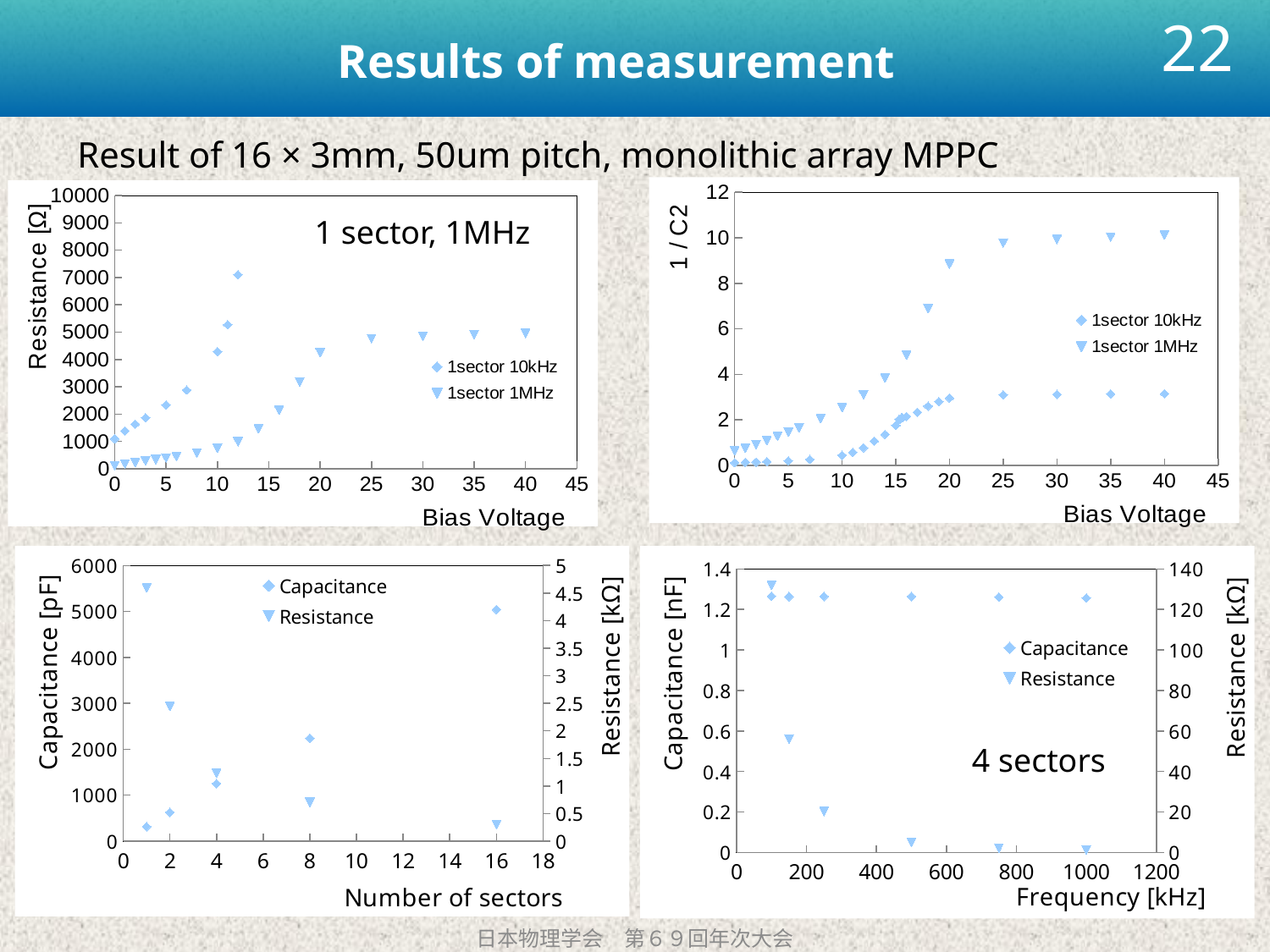
In the top-left chart (Resistance vs Bias Voltage), at a bias voltage of 12, which series has the larger value, 1sector 10kHz or 1sector 1MHz? 1sector 10kHz In the bottom-left chart (Capacitance vs Number of sectors), how many data points does the Capacitance series have? 5 In the top-left chart (Resistance vs Bias Voltage), is the 1sector 1MHz value at a bias voltage of 10 greater or less than 1000? less In the bottom-left chart (Capacitance vs Number of sectors), is the Capacitance value at 16 sectors greater or less than 4000? greater What is the x-axis title of the bottom-right chart? Frequency [kHz] In the bottom-right chart (Capacitance vs Frequency), is the Resistance value at 150 kHz greater or less than 40? greater How many series does the legend of the top-right chart (1/C2 vs Bias Voltage) list? 2 What kind of chart is the top-left chart (Resistance vs Bias Voltage)? scatter chart In the top-right chart (1/C2 vs Bias Voltage), at a bias voltage of 40, which series has the larger value, 1sector 10kHz or 1sector 1MHz? 1sector 1MHz In the bottom-left chart (Capacitance vs Number of sectors), does the Resistance series rise or fall as the number of sectors increases? fall